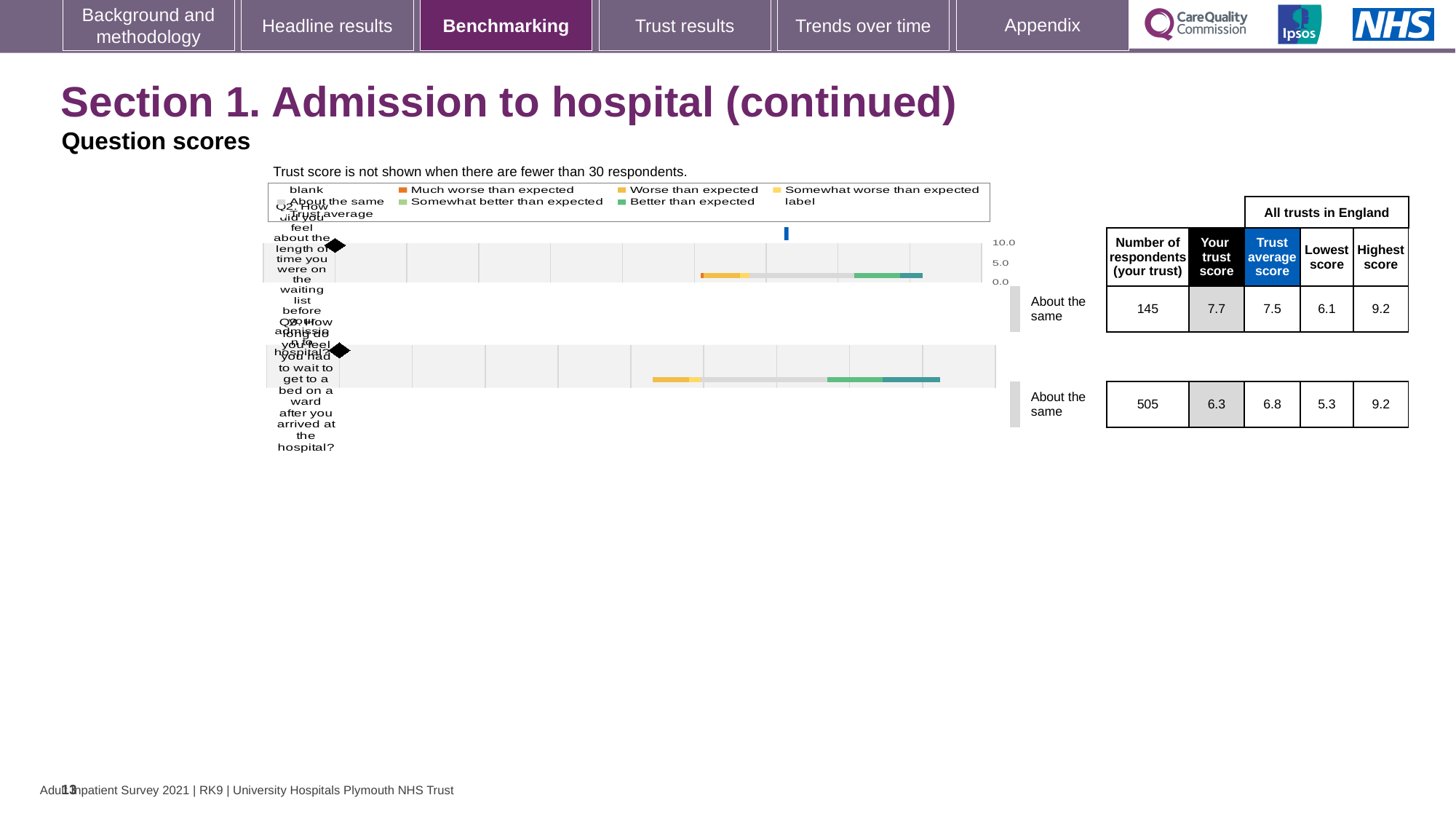
Is the trust score for Q3 greater or less than 5.0 on the axis? greater What kind of chart is used to show the question scores on this slide? bar chart What is the difference between the highest and lowest scores for Q3? 3.9 What is the trust average score for Q2? 7.5 How many respondents answered Q3 for this trust? 505 What is the lowest score across all trusts in England for Q2? 6.1 Which question has the higher trust score, Q2 or Q3? Q2 What is the trust average score for Q3? 6.8 How many questions (Q2 and Q3) are plotted on the slide? 2 What is the trust score for Q2 (how did you feel about the length of time on the waiting list)? 7.7 What is the difference between the trust score and the trust average score for Q2? 0.2 What is the trust score for Q3 (how long did you feel you had to wait to get to a bed on a ward)? 6.3